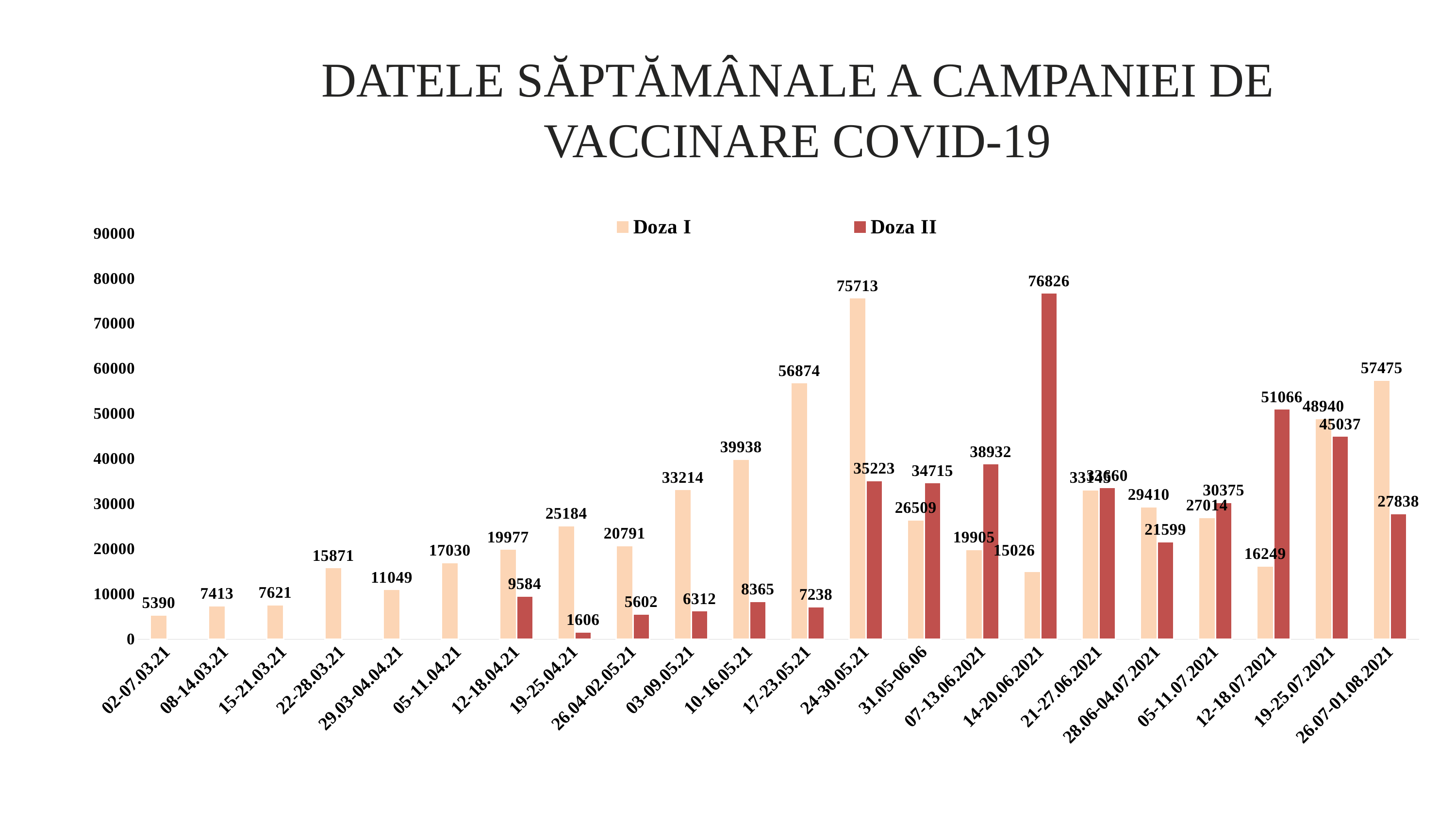
Which week has the highest Doza II value? 14-20.06.2021 How many series does the legend list? 2 Is the Doza I value for the week 10-16.05.21 greater or less than 30000? greater What is the Doza I value for the week 17-23.05.21? 56874 What kind of chart is shown on the slide? bar chart What is the difference between Doza I and Doza II in the week 19-25.07.2021? 3903 Which week has the highest Doza I value? 24-30.05.21 In the week 26.07-01.08.2021, which is larger, Doza I or Doza II? Doza I What is the Doza II value for the week 12-18.07.2021? 51066 What is the difference between Doza I and Doza II in the week 24-30.05.21? 40490 How many weekly categories are shown on the x axis? 22 Which week has the lowest Doza II value among the weeks where Doza II is shown? 19-25.04.21